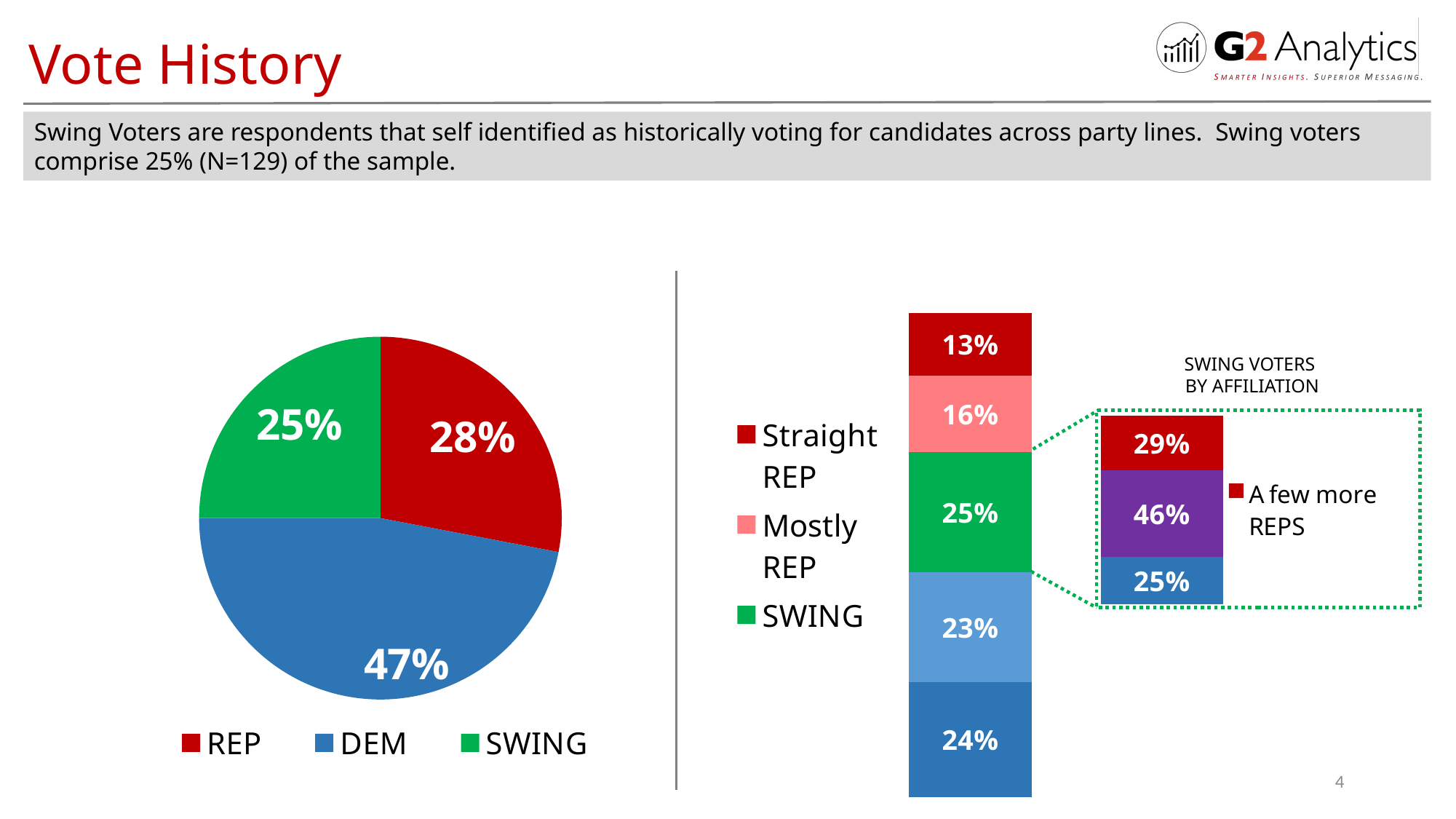
What kind of chart is the chart on the left of the slide? Pie chart How many slices does the pie chart have? 3 In the Swing Voters by Affiliation chart, what is the value of the largest segment? 46% In the pie chart, what share of the sample is REP? 28% In the stacked bar chart in the middle of the slide, how much larger is Mostly REP than Straight REP? 3% In the stacked bar chart in the middle of the slide, what is the value for Straight REP? 13% In the pie chart, which category has the smallest slice? SWING In the pie chart, what share of the sample is DEM? 47% In the pie chart, which category has the largest slice? DEM In the stacked bar chart in the middle of the slide, what is the value for SWING? 25% In the pie chart, which is larger, REP or SWING? REP In the stacked bar chart in the middle of the slide, what is the value for Mostly REP? 16%